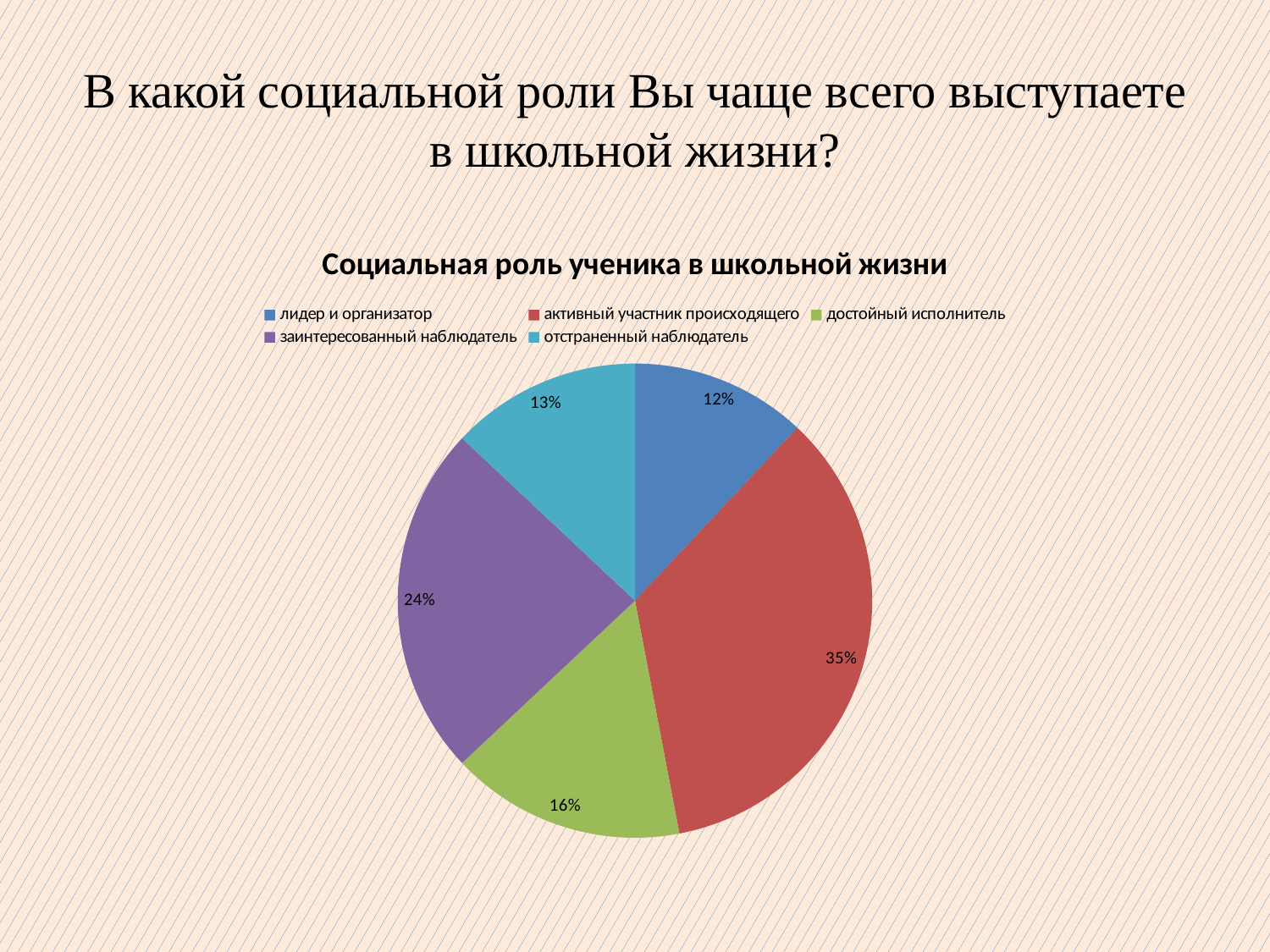
What is the difference in percentage points between "активный участник происходящего" and "заинтересованный наблюдатель"? 11 What percentage is shown for "активный участник происходящего"? 35% Which is larger: the share for "достойный исполнитель" or the share for "отстраненный наблюдатель"? достойный исполнитель What percentage is shown for "лидер и организатор"? 12% What is the title of the chart? Социальная роль ученика в школьной жизни Which category has the largest share of the pie? активный участник происходящего What percentage is shown for "достойный исполнитель"? 16% Which category has the smallest share of the pie? лидер и организатор How many slices does the pie chart have? 5 What kind of chart is shown on the slide? Pie chart What percentage is shown for "отстраненный наблюдатель"? 13% What percentage is shown for "заинтересованный наблюдатель"? 24%